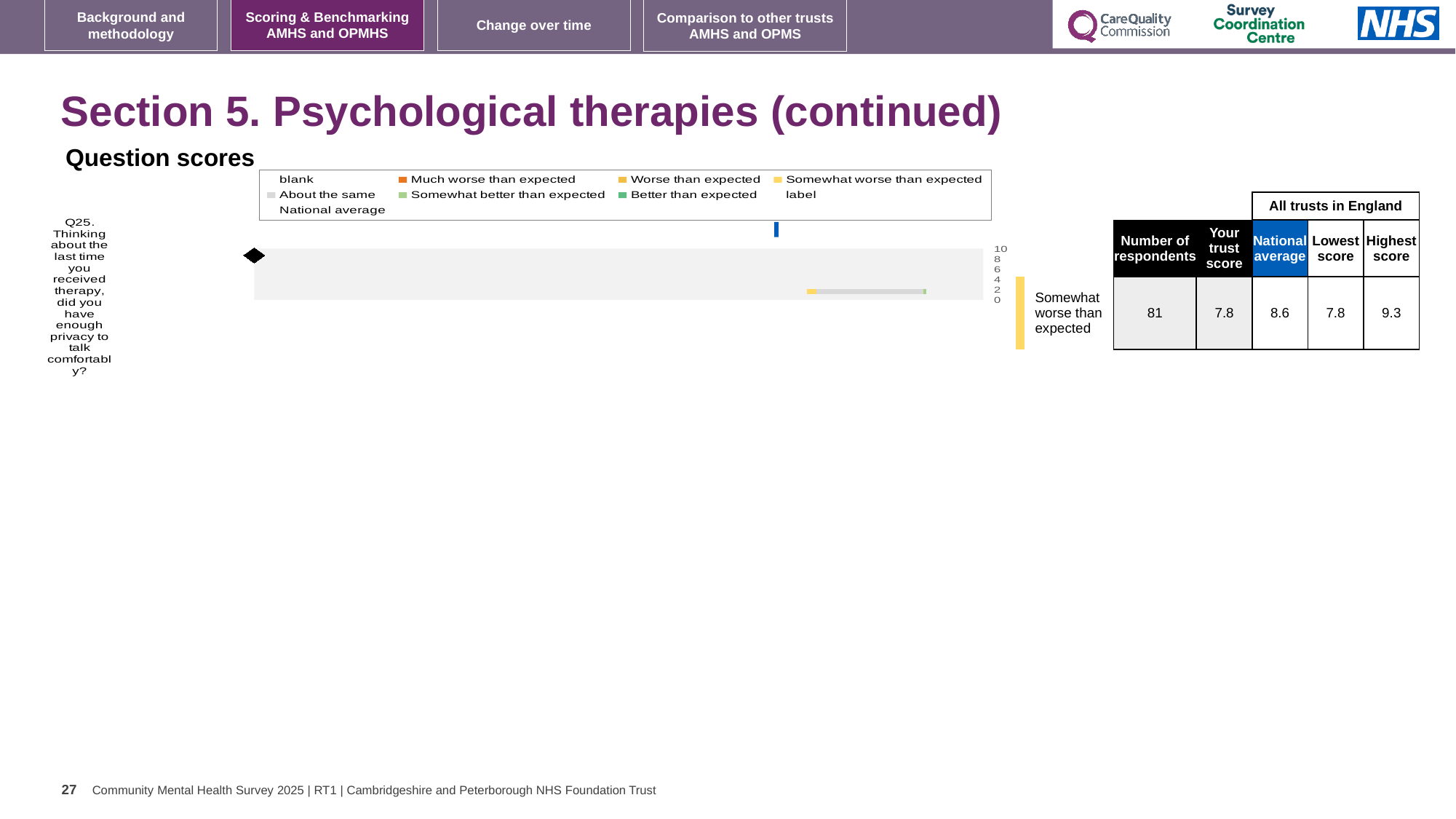
What benchmark category is given for Q25 next to the chart? Somewhat worse than expected What is the trust score for Q25? 7.8 What is the lowest score among all trusts in England for Q25? 7.8 What is the highest score among all trusts in England for Q25? 9.3 What is the national average score for Q25? 8.6 How many questions are plotted in the Question scores chart? 1 Which question number is plotted in the Question scores chart? Q25 How many respondents answered Q25? 81 For Q25, what is the difference between the highest score and the lowest score among all trusts in England? 1.5 For Q25, which is larger: the trust score or the national average? national average What kind of chart is used to show the Q25 question score? bar chart In the chart legend, which entry is shown in orange? Much worse than expected